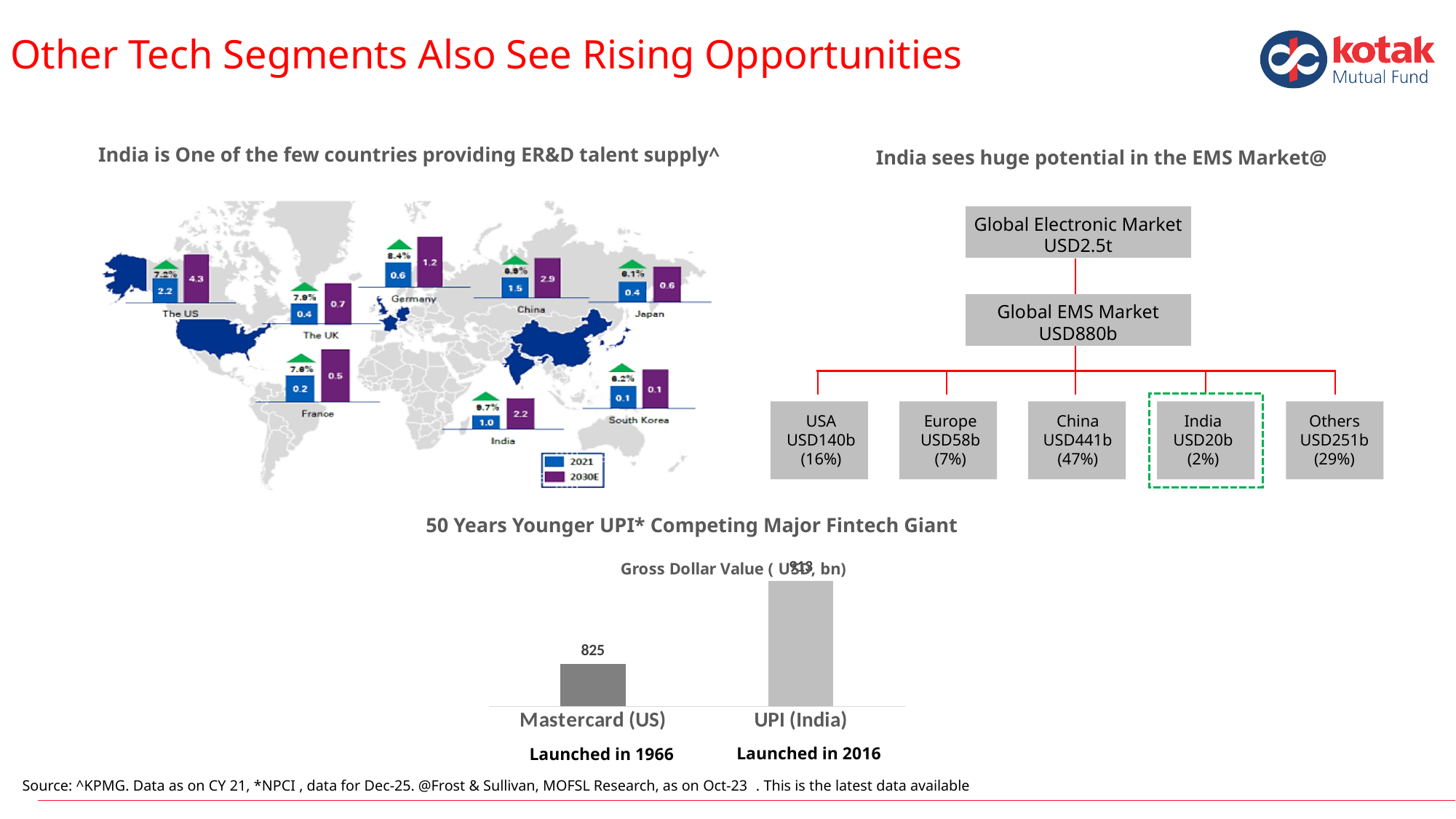
In the bottom chart titled 'Gross Dollar Value ( USD, bn)', what is the value for Mastercard (US)? 825 In the ER&D talent supply map chart on the left, which is larger, the 2030E value for India or the 2030E value for Germany? India In the ER&D talent supply map chart on the left, what is the 2030E value for China? 2.9 In the ER&D talent supply map chart on the left, which country has the highest 2030E value? The US In the ER&D talent supply map chart on the left, what is the 2030E value for The US? 4.3 In the ER&D talent supply map chart on the left, what is the 2021 value for India? 1.0 In the ER&D talent supply map chart on the left, what is the difference between the 2030E and 2021 values for The US? 2.1 In the ER&D talent supply map chart on the left, how many series does the legend list? 2 What kind of chart is the 'Gross Dollar Value ( USD, bn)' chart at the bottom of the slide? bar chart In the bottom chart titled 'Gross Dollar Value ( USD, bn)', which is larger, the bar for Mastercard (US) or the bar for UPI (India)? UPI (India) In the bottom chart, in which year was UPI (India) launched according to the label under the bar? 2016 How many categories are shown in the bottom 'Gross Dollar Value ( USD, bn)' chart? 2